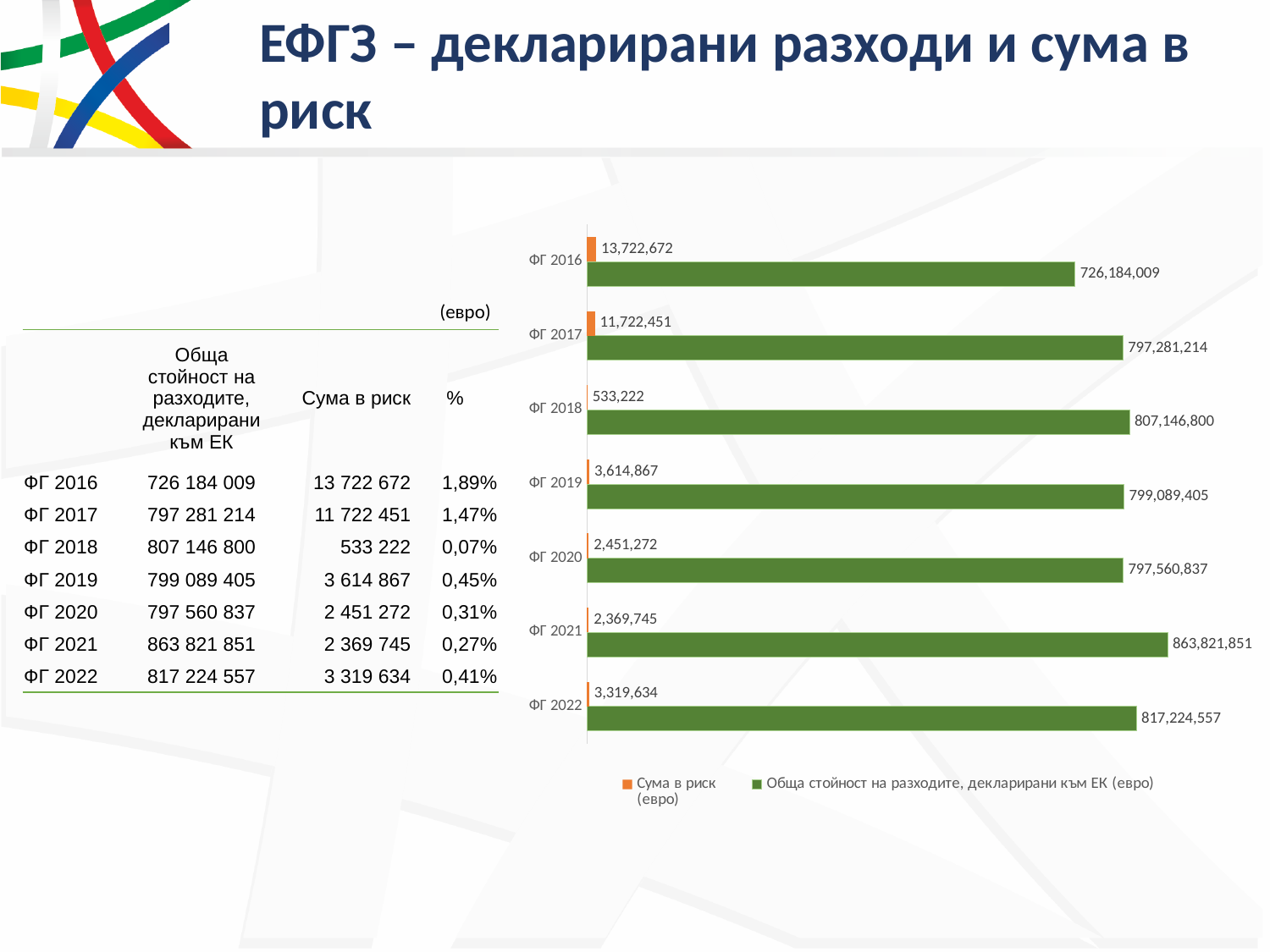
Is the "Обща стойност на разходите, декларирани към ЕК (евро)" larger for ФГ 2018 or ФГ 2022 in the chart? ФГ 2022 How many series does the chart legend list? 2 What is the value of "Сума в риск (евро)" for ФГ 2018 in the chart? 533,222 What is the value of "Сума в риск (евро)" for ФГ 2016 in the chart? 13,722,672 Which colour represents the "Сума в риск (евро)" series in the chart? Orange What type of chart is shown on the slide? Bar chart Which financial year has the lowest "Сума в риск (евро)" in the chart? ФГ 2018 Which financial year has the highest "Сума в риск (евро)" in the chart? ФГ 2016 What is the difference between the "Сума в риск (евро)" values for ФГ 2016 and ФГ 2017 in the chart? 2,000,221 What is the value of "Обща стойност на разходите, декларирани към ЕК (евро)" for ФГ 2021 in the chart? 863,821,851 Which financial year has the highest "Обща стойност на разходите, декларирани към ЕК (евро)" in the chart? ФГ 2021 How many financial years (categories) are plotted in the chart? 7